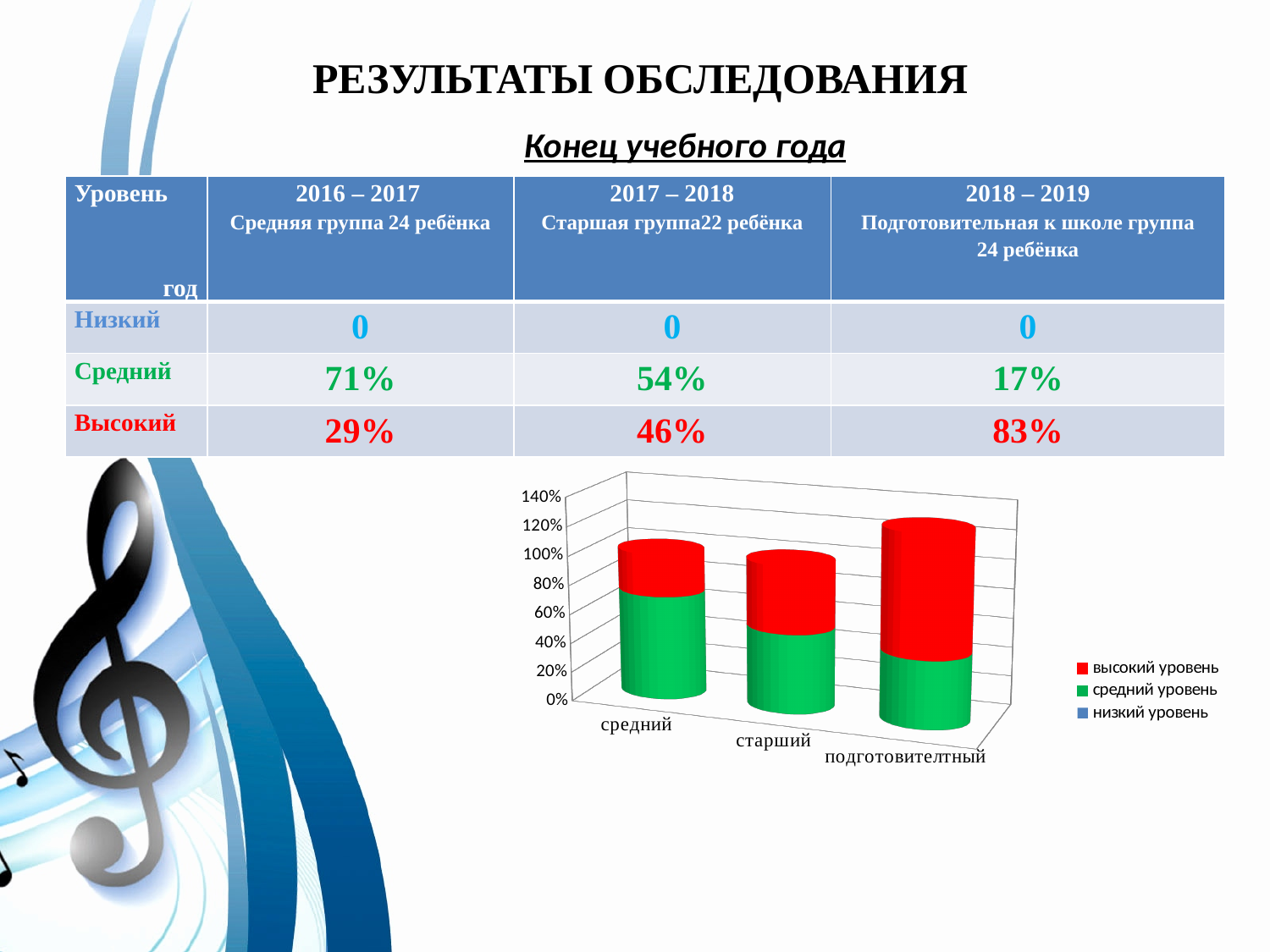
How many categories are shown on the x axis of the chart? 3 What kind of chart is shown on the slide? stacked bar chart Do the green (средний уровень) segments rise or fall from left to right across the categories? fall Is the green (средний уровень) segment for старший greater or less than 40%? greater Is the green (средний уровень) segment for средний greater or less than 60%? greater Which category has the smallest green (средний уровень) segment in the chart? подготовителтный Which category has the largest red (высокий уровень) segment in the chart? подготовителтный Which has the larger green (средний уровень) segment: средний or старший? средний How many series does the chart legend list? 3 Which category has the tallest green (средний уровень) segment in the chart? средний What colour represents высокий уровень in the chart legend? red